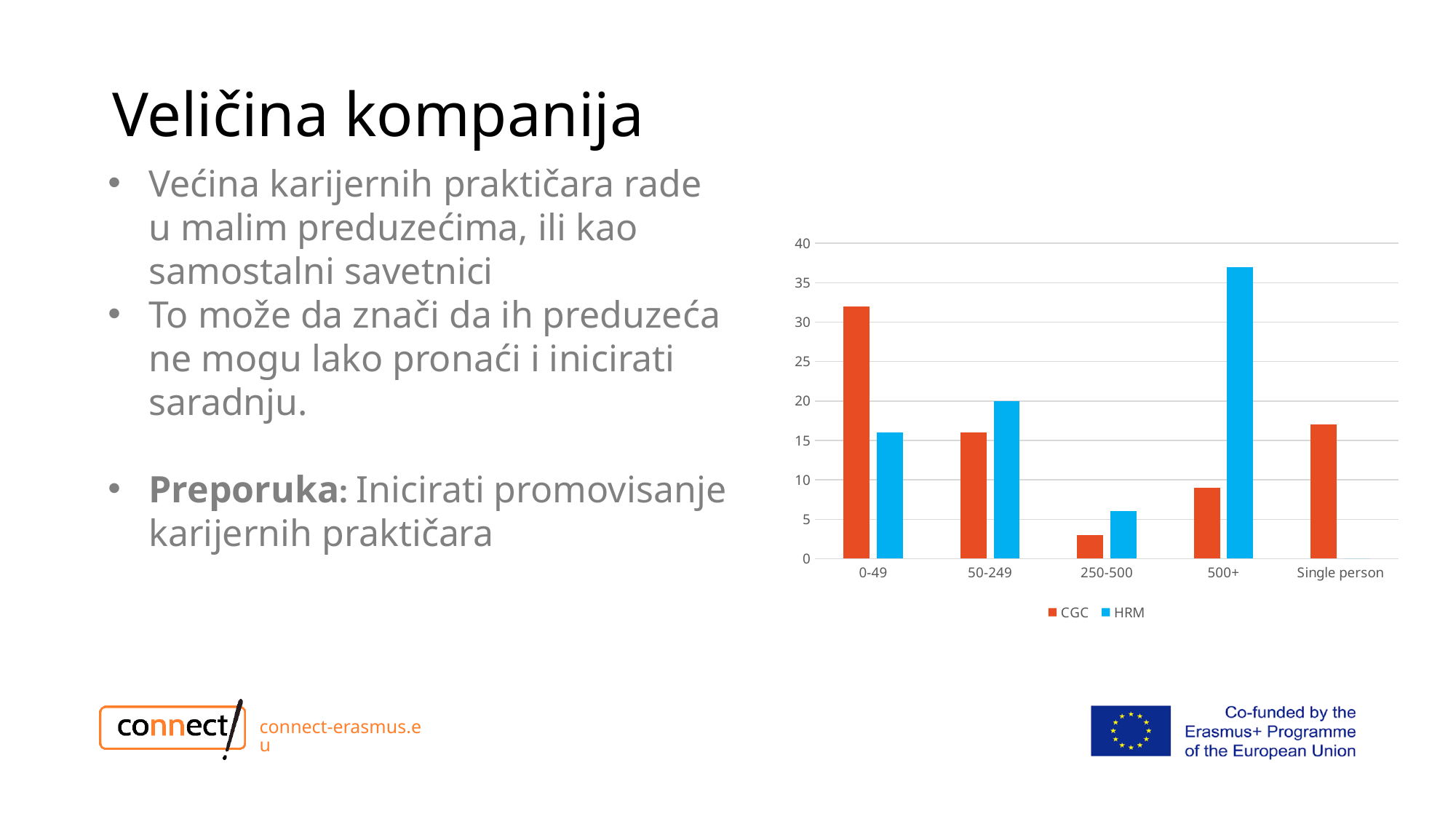
Which category has the highest CGC value in the chart? 0-49 How many company-size categories are shown on the x axis of the chart? 5 Is the CGC value for 0-49 greater or less than 30? greater Which category has the highest HRM value in the chart? 500+ Is the CGC value for 250-500 greater or less than 5? less Is the HRM value for 500+ greater or less than 35? greater For the 500+ category, which series has the larger value, CGC or HRM? HRM Which category in the chart has no HRM bar? Single person Which category has the lowest CGC value in the chart? 250-500 How many series does the chart legend list? 2 For the 0-49 category, which series has the larger value, CGC or HRM? CGC What kind of chart is shown on the slide? bar chart